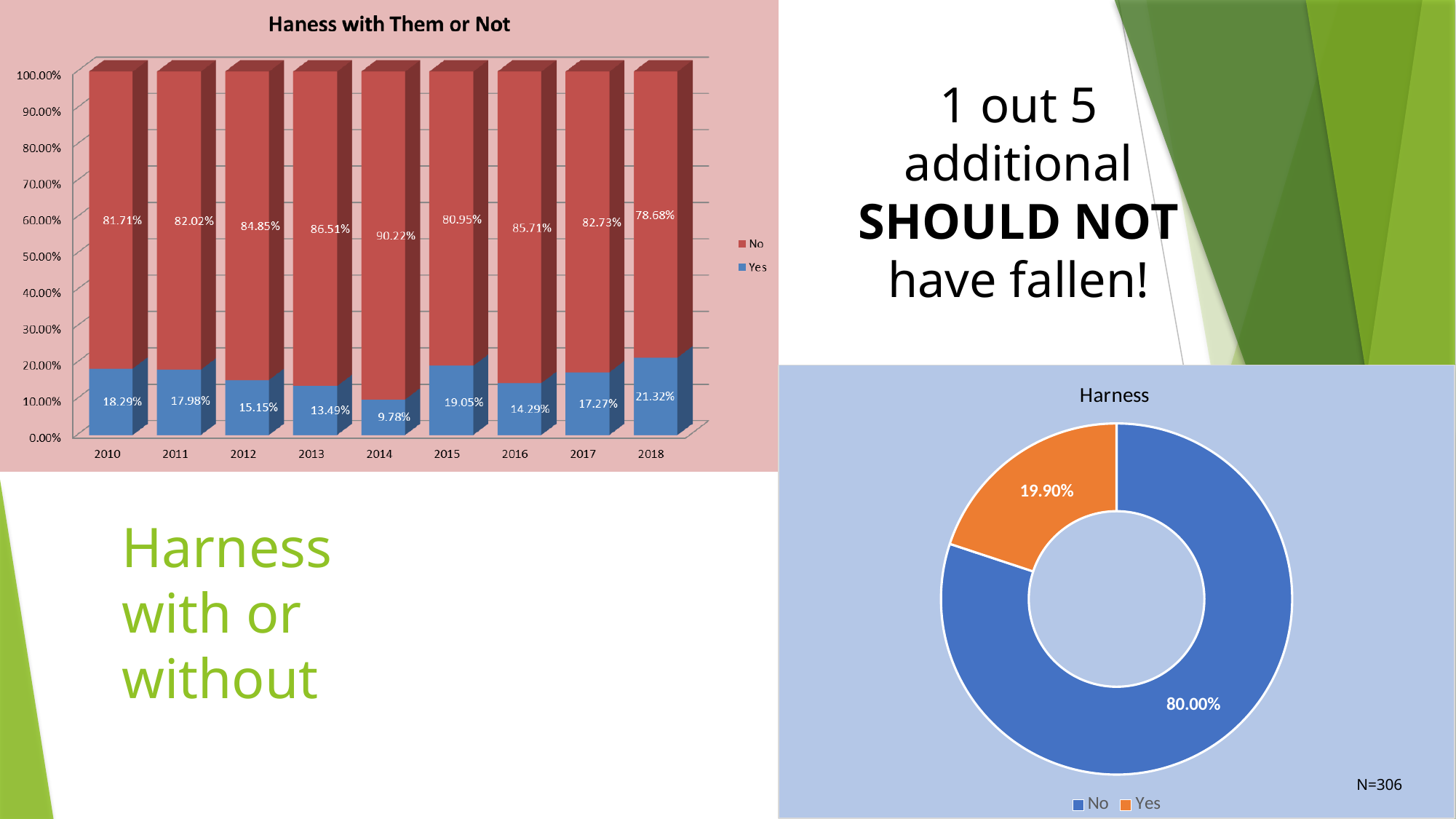
In the 'Haness with Them or Not' chart, is the 'Yes' value larger in 2015 or in 2016? 2015 In the 'Harness' chart, what share of the pie is 'Yes'? 19.90% What kind of chart is the 'Harness' chart? Doughnut chart In the 'Haness with Them or Not' chart, how many series does the legend list? 2 In the 'Haness with Them or Not' chart, how many years are shown on the x axis? 9 In the 'Haness with Them or Not' chart, what is the difference between the 'No' values for 2014 and 2018? 11.54% In the 'Haness with Them or Not' chart, which year has the lowest 'Yes' value? 2014 In the 'Haness with Them or Not' chart, what is the 'Yes' value for 2014? 9.78% In the 'Haness with Them or Not' chart, which year has the highest 'Yes' value? 2018 What kind of chart is the 'Haness with Them or Not' chart? Stacked bar chart In the 'Harness' chart, which slice is larger, 'No' or 'Yes'? No In the 'Haness with Them or Not' chart, what is the 'No' value for 2013? 86.51%